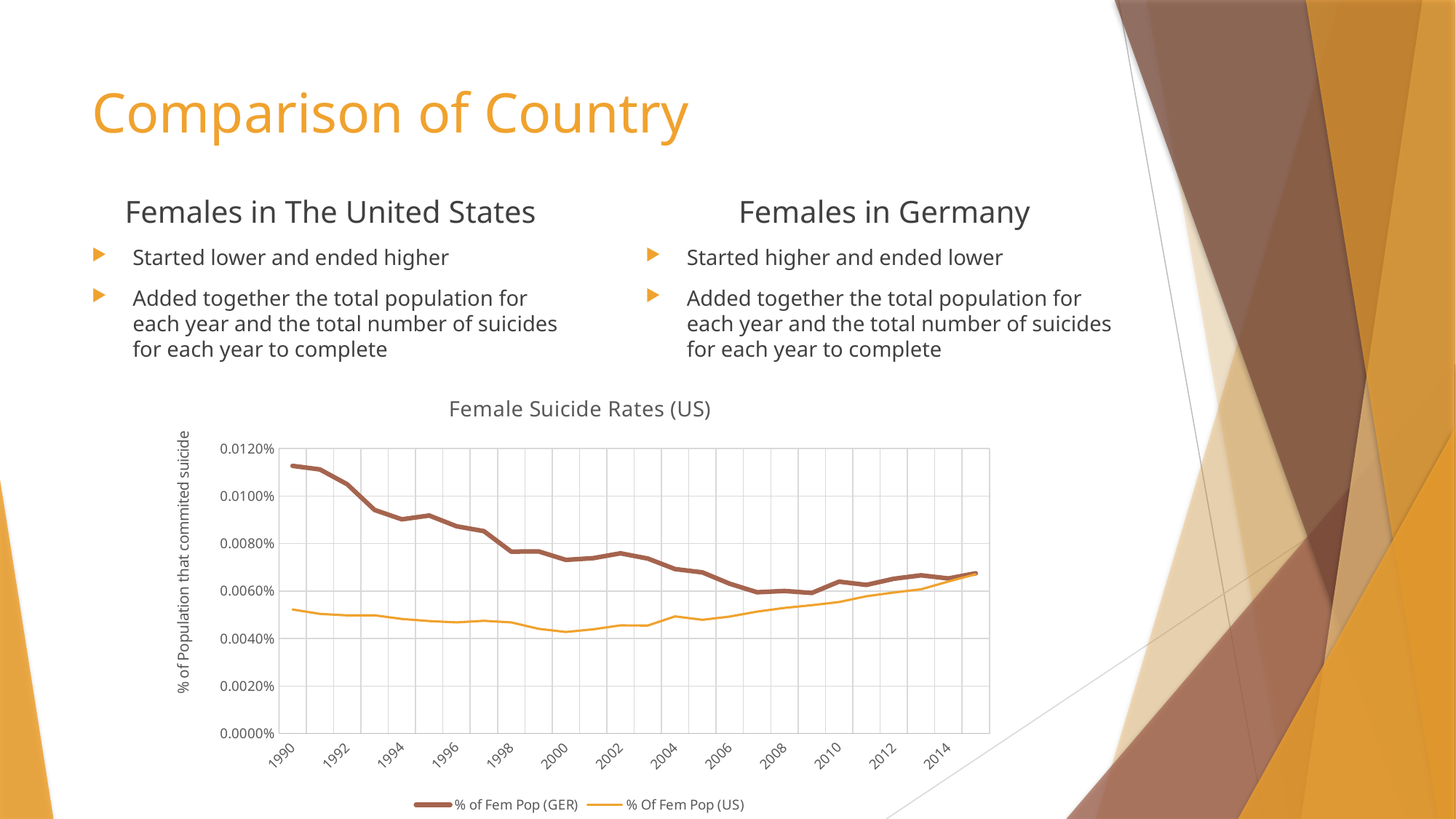
Is the value for % of Fem Pop (GER) in 2008 greater or less than 0.0080%? less Does the % of Fem Pop (GER) series rise or fall overall from 1990 to the end of the chart? fall How many series does the legend list? 2 In which year does the % of Fem Pop (GER) series reach its highest value? 1990 Is the value for % Of Fem Pop (US) in 2010 greater or less than 0.0040%? greater In 1990, which series has the larger value, % of Fem Pop (GER) or % Of Fem Pop (US)? % of Fem Pop (GER) What kind of chart is shown on the slide? line chart Does the % Of Fem Pop (US) series rise or fall overall from 1990 to the end of the chart? rise What is the title of the chart? Female Suicide Rates (US) What are the two series named in the legend? % of Fem Pop (GER) and % Of Fem Pop (US) Is the value for % of Fem Pop (GER) in 1990 greater or less than 0.0100%? greater